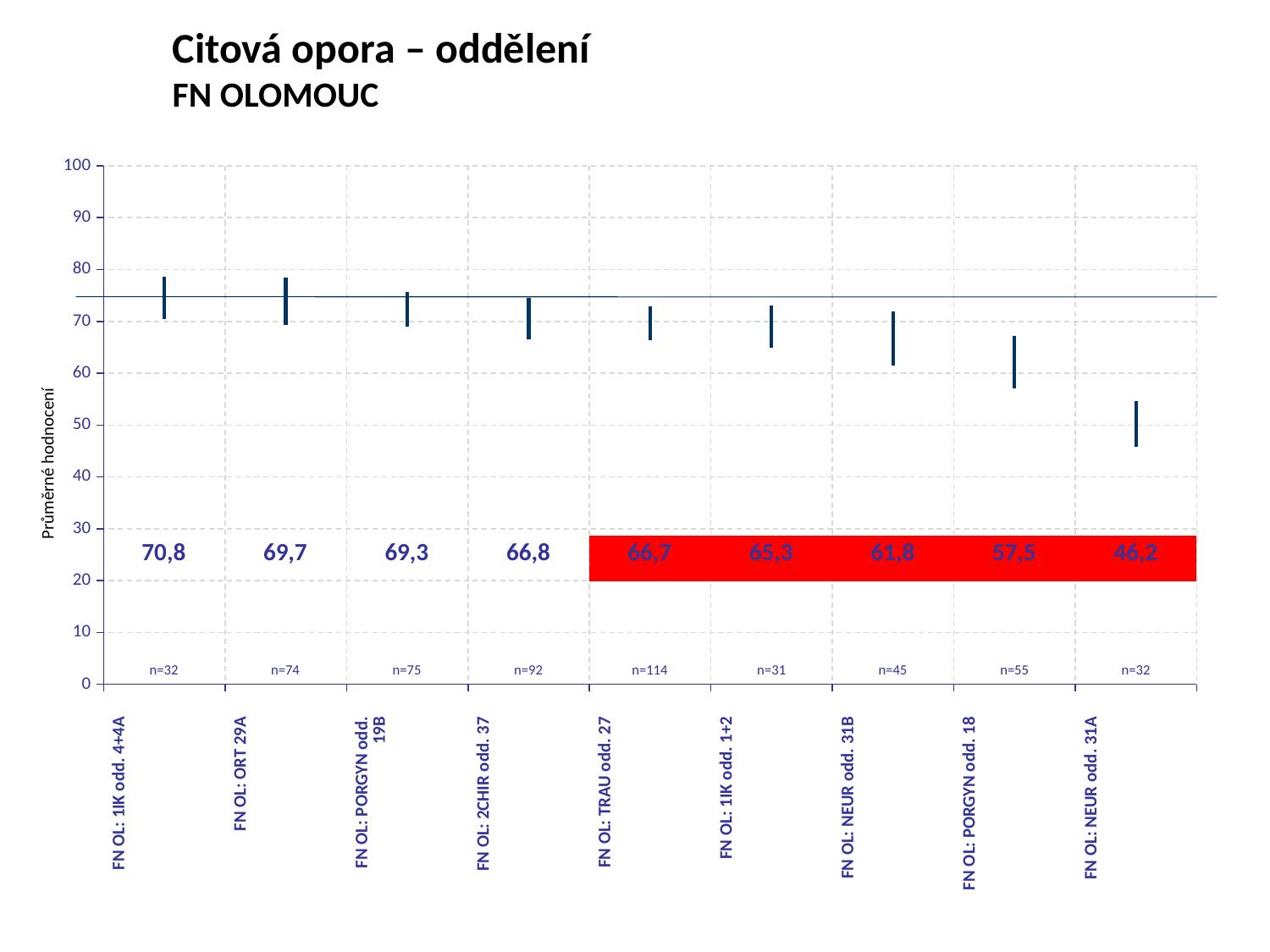
What is the value shown for FN OL: NEUR odd. 31A? 46,2 Which department has the highest value? FN OL: 1IK odd. 4+4A Do the values rise or fall from left to right along the x axis? fall What is the difference between the values for FN OL: 1IK odd. 4+4A and FN OL: NEUR odd. 31A? 24,6 What is the value shown for FN OL: 1IK odd. 4+4A? 70,8 What is the value shown for FN OL: TRAU odd. 27? 66,7 Which has a larger value, FN OL: 2CHIR odd. 37 or FN OL: 1IK odd. 1+2? FN OL: 2CHIR odd. 37 How many departments are shown on the chart? 9 What is the difference between the values for FN OL: NEUR odd. 31B and FN OL: PORGYN odd. 18? 4,3 What is the sample size (n) shown for FN OL: TRAU odd. 27? n=114 Which department has the lowest value? FN OL: NEUR odd. 31A What is the value shown for FN OL: PORGYN odd. 18? 57,5